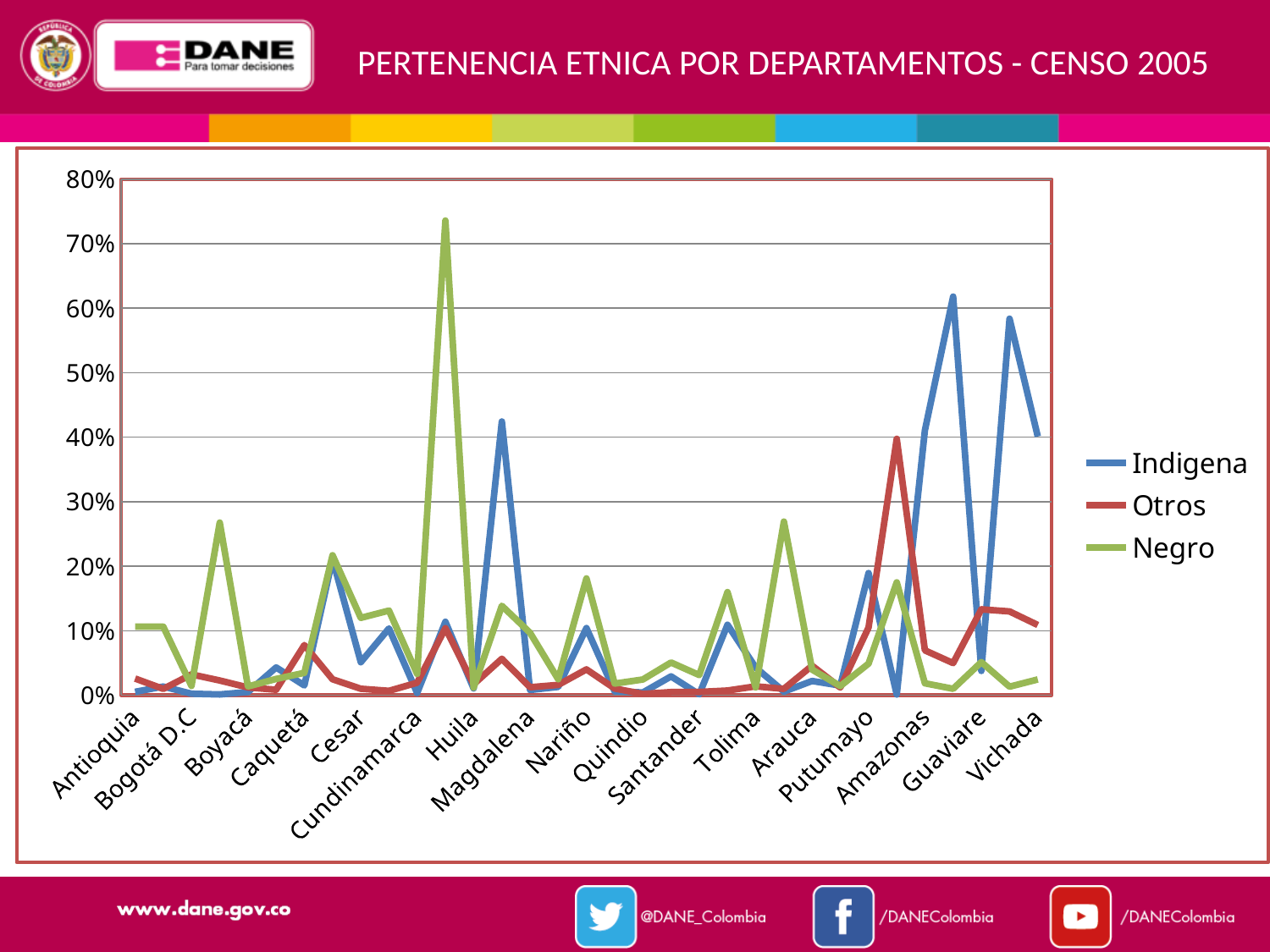
For Vichada, which is larger: the Indigena value or the Negro value? Indigena Is the Indigena value for Vichada greater or less than 30%? greater Is the highest value of the Otros series greater or less than 50%? less For Antioquia, which is larger: the Negro value or the Indigena value? Negro Is the Indigena value for Antioquia greater or less than 5%? less What is the title of the chart? PERTENENCIA ETNICA POR DEPARTAMENTOS - CENSO 2005 Which series reaches the highest value anywhere on the chart? Negro What kind of chart is shown on the slide? Line chart How many series does the legend list? 3 Which colour is used for the Negro series? Green